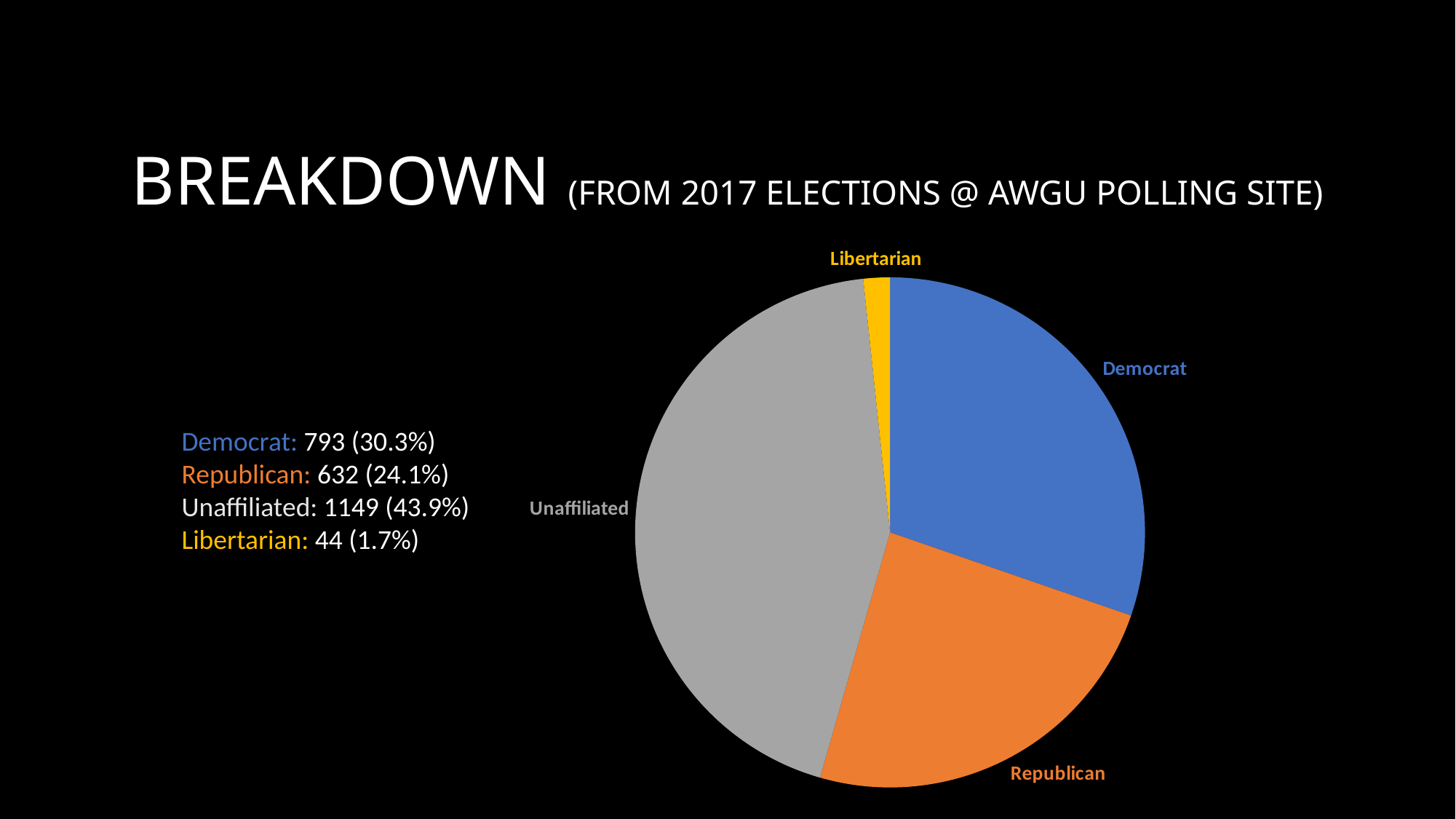
What is the value for Democrat? 793 What share of the pie does Unaffiliated represent? 43.9% What colour is the Unaffiliated slice? Gray What share of the pie does Libertarian represent? 1.7% What is the difference between the Democrat and Republican values? 161 What is the value for Unaffiliated? 1149 How many slices does the pie chart have? 4 Which category has the largest slice of the pie? Unaffiliated What is the value for Republican? 632 Which category has the smallest slice of the pie? Libertarian Which is larger, the Democrat slice or the Republican slice? Democrat What kind of chart is shown on the slide? Pie chart